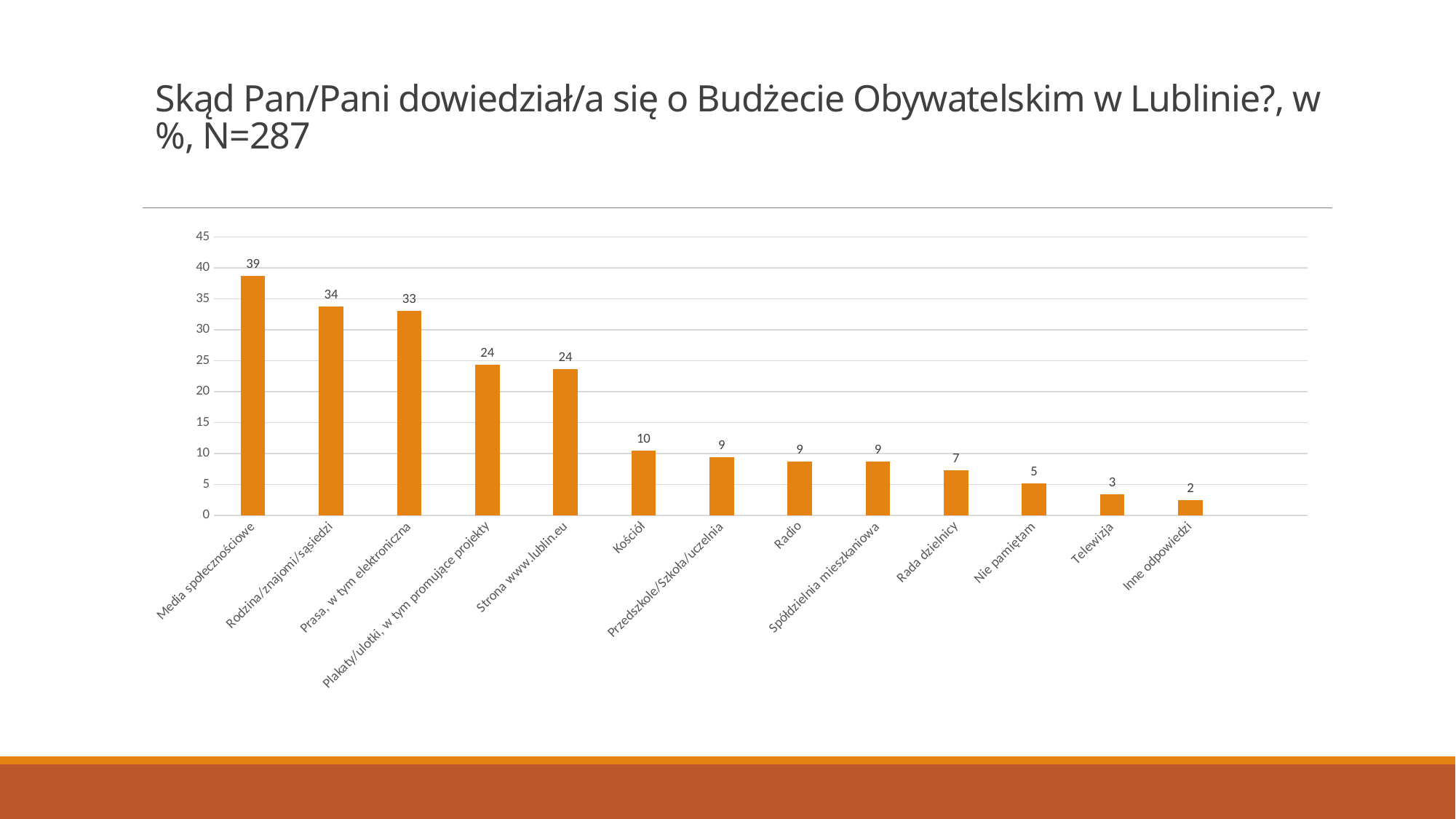
How many categories are shown on the chart? 13 What kind of chart is shown on the slide? bar chart Which is larger, the value for Prasa, w tym elektroniczna or the value for Strona www.lublin.eu? Prasa, w tym elektroniczna Do the values rise or fall from left to right along the x axis? fall What is the difference between the values for Media społecznościowe and Rodzina/znajomi/sąsiedzi? 5 What is the value for Kościół? 10 What is the sample size (N) stated in the chart title? 287 Which category has the highest value? Media społecznościowe Which category has the lowest value? Inne odpowiedzi What is the value for Nie pamiętam? 5 What is the value for Media społecznościowe? 39 Is the value for Rada dzielnicy greater or less than 10? less